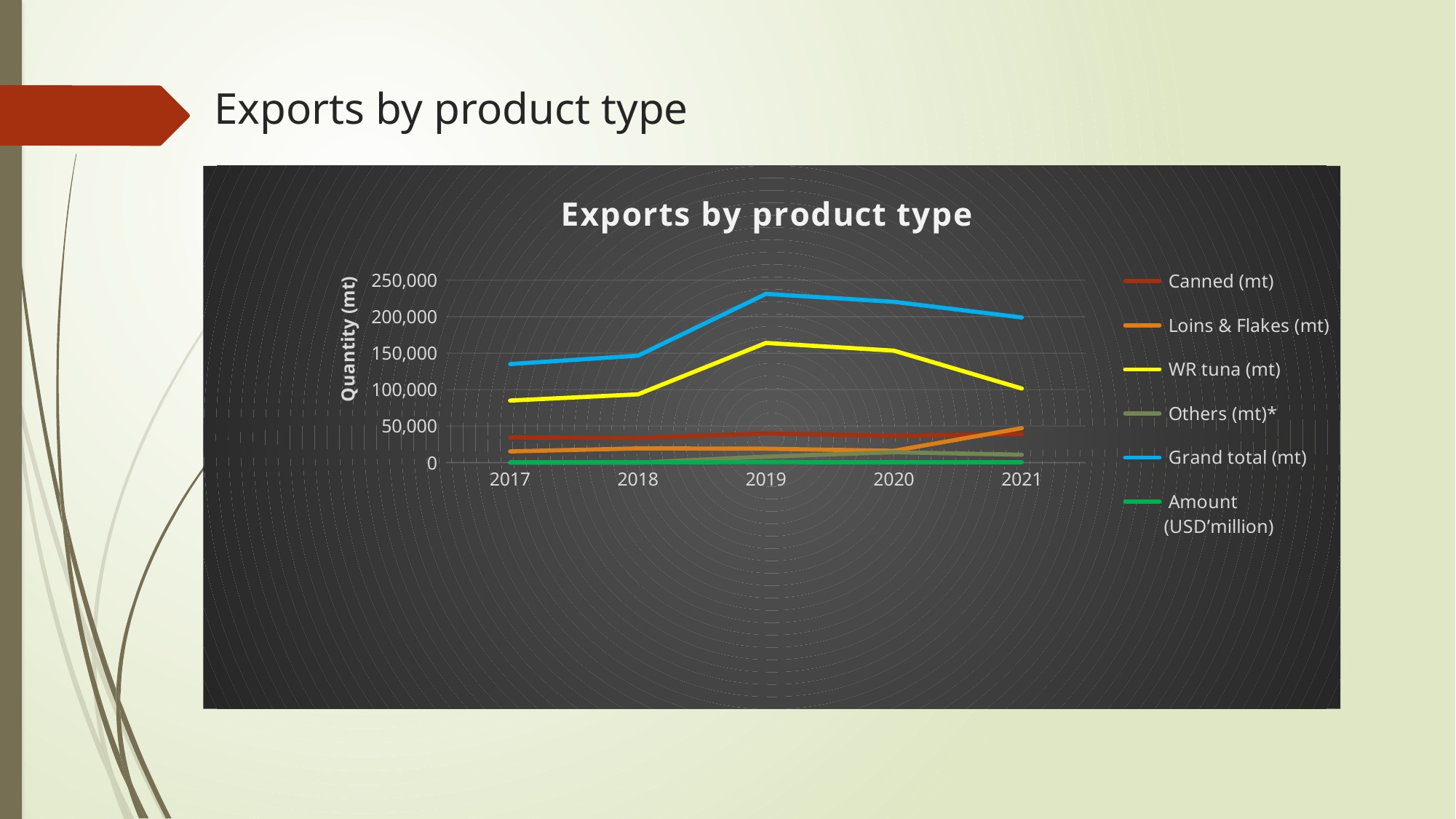
Is the Grand total (mt) value for 2017 greater or less than 150,000? less Which is larger in 2017, Canned (mt) or Loins & Flakes (mt)? Canned (mt) How many years are plotted along the x axis? 5 Is the Grand total (mt) value for 2019 greater or less than 200,000? greater Is the WR tuna (mt) value for 2017 greater or less than 100,000? less What is the label on the vertical axis of the chart? Quantity (mt) In which year does the Grand total (mt) line reach its highest value? 2019 How many series does the legend list? 6 Does the Grand total (mt) line rise or fall from 2019 to 2021? fall In which year is the Grand total (mt) line at its lowest? 2017 In which year does the WR tuna (mt) line peak? 2019 What kind of chart is shown on the slide? line chart